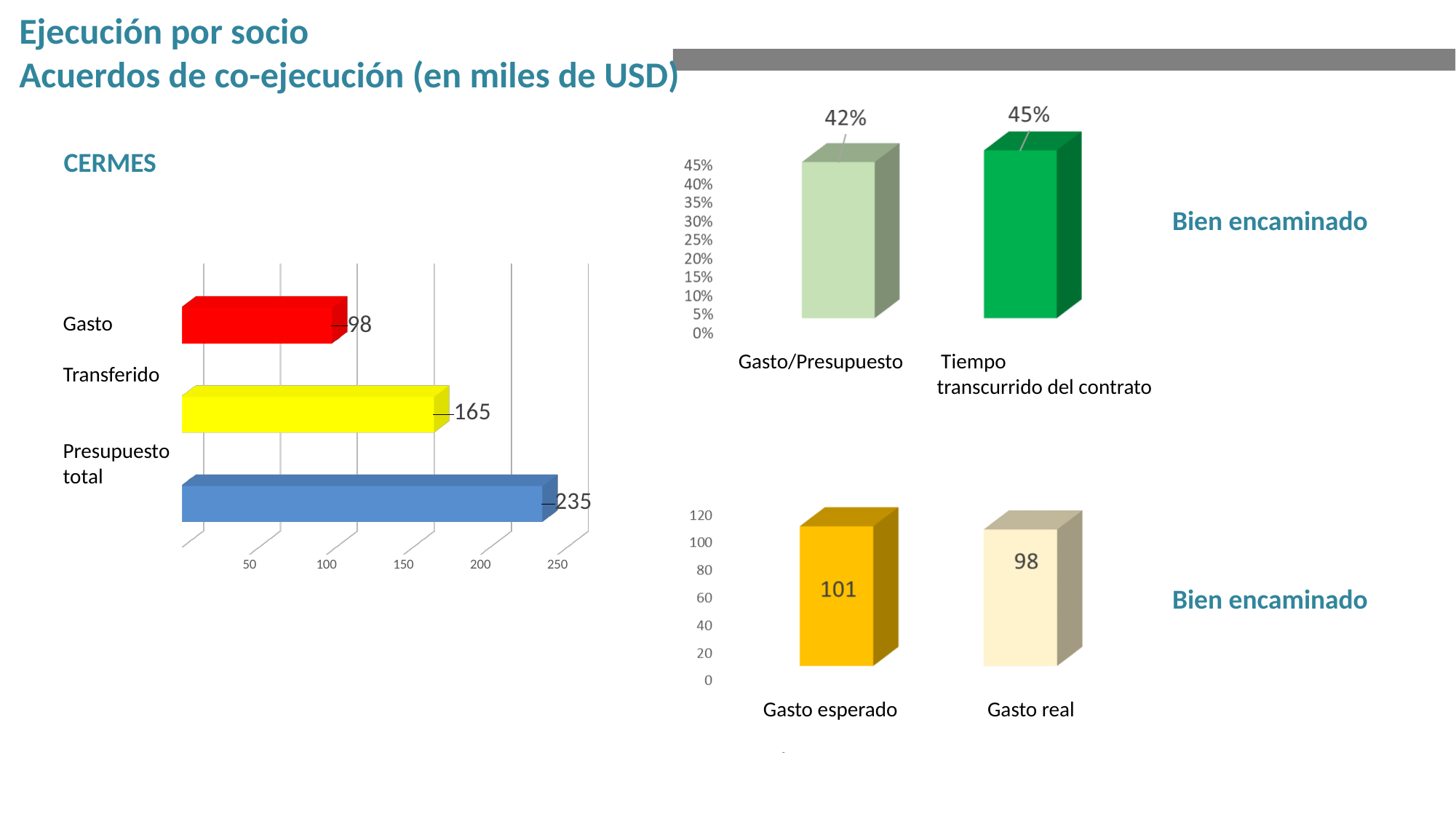
In the CERMES chart on the left, which category has the highest value? Presupuesto total In the bottom-right chart, which is larger, Gasto esperado or Gasto real? Gasto esperado In the top-right chart, what is the value for Gasto/Presupuesto? 42% In the CERMES chart on the left, what is the value for Gasto? 98 In the CERMES chart on the left, what is the difference between Presupuesto total and Transferido? 70 In the CERMES chart on the left, what is the value for Transferido? 165 In the bottom-right chart, what is the difference between Gasto esperado and Gasto real? 3 In the CERMES chart on the left, which category has the lowest value? Gasto In the CERMES chart on the left, how many categories are plotted? 3 In the top-right chart, what is the value for Tiempo transcurrido del contrato? 45% In the CERMES chart on the left, what is the value for Presupuesto total? 235 What kind of chart is the CERMES chart on the left? Bar chart